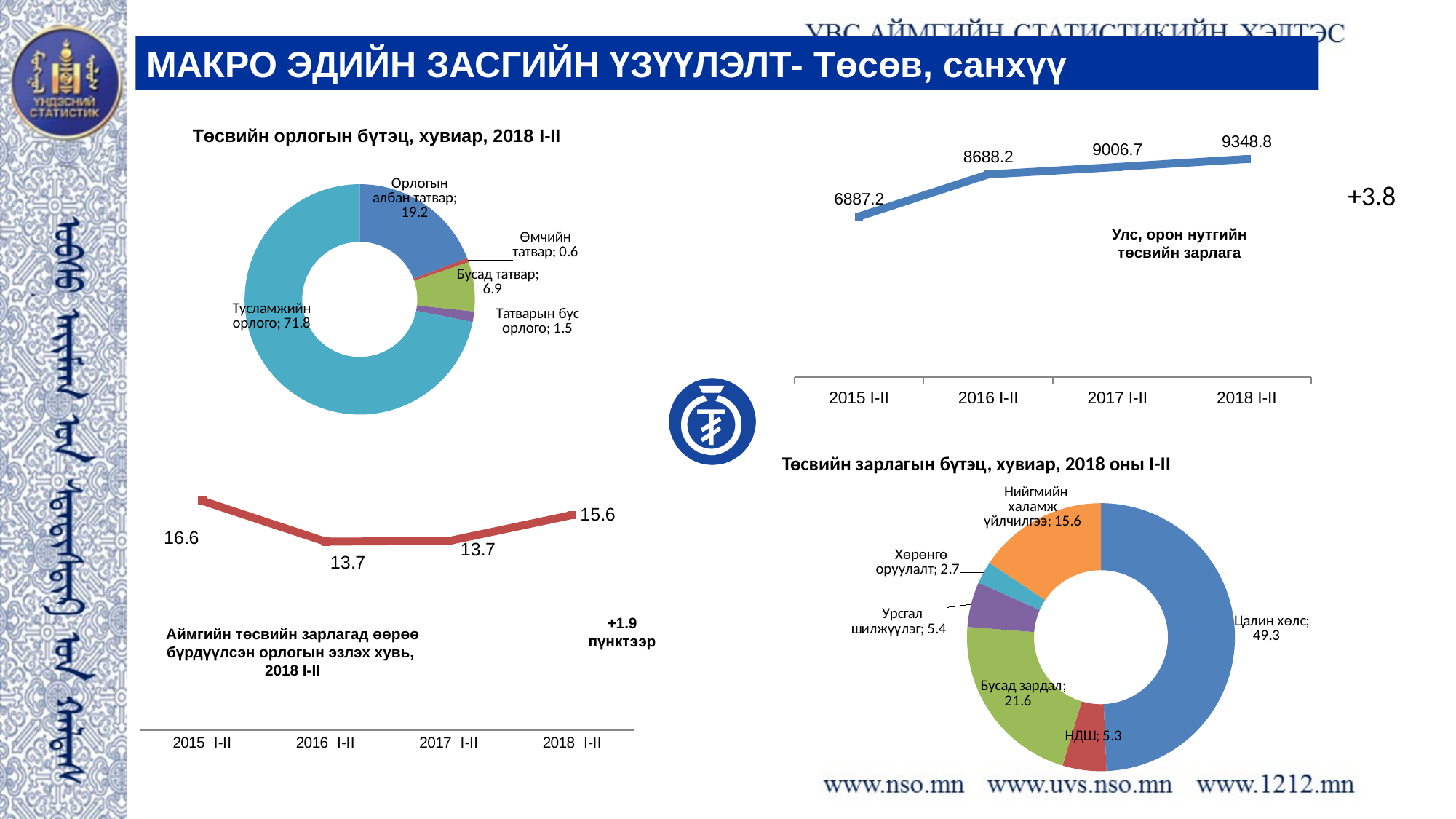
In the chart titled 'Төсвийн зарлагын бүтэц, хувиар, 2018 оны I-II', which is larger: 'Урсгал шилжүүлэг' or 'Хөрөнгө оруулалт'? Урсгал шилжүүлэг In the chart titled 'Улс, орон нутгийн төсвийн зарлага', do the values rise or fall from 2015 I-II to 2018 I-II? rise In the chart titled 'Аймгийн төсвийн зарлагад өөрөө бүрдүүлсэн орлогын эзлэх хувь, 2018 I-II', what is the value for 2015 I-II? 16.6 In the chart titled 'Төсвийн орлогын бүтэц, хувиар, 2018 I-II', which category has the smallest value? Өмчийн татвар In the chart titled 'Улс, орон нутгийн төсвийн зарлага', what is the difference between 2018 I-II and 2015 I-II? 2461.6 In the chart titled 'Төсвийн орлогын бүтэц, хувиар, 2018 I-II', how many categories are shown? 5 What kind of chart is the one titled 'Төсвийн зарлагын бүтэц, хувиар, 2018 оны I-II'? doughnut chart In the chart titled 'Төсвийн орлогын бүтэц, хувиар, 2018 I-II', what is the difference between 'Орлогын албан татвар' and 'Бусад татвар'? 12.3 In the chart titled 'Төсвийн орлогын бүтэц, хувиар, 2018 I-II', what is the value for 'Тусламжийн орлого'? 71.8 In the chart titled 'Улс, орон нутгийн төсвийн зарлага', what is the value for 2016 I-II? 8688.2 In the chart titled 'Аймгийн төсвийн зарлагад өөрөө бүрдүүлсэн орлогын эзлэх хувь, 2018 I-II', which year has the highest value? 2015 I-II In the chart titled 'Төсвийн зарлагын бүтэц, хувиар, 2018 оны I-II', what is the value for 'Бусад зардал'? 21.6